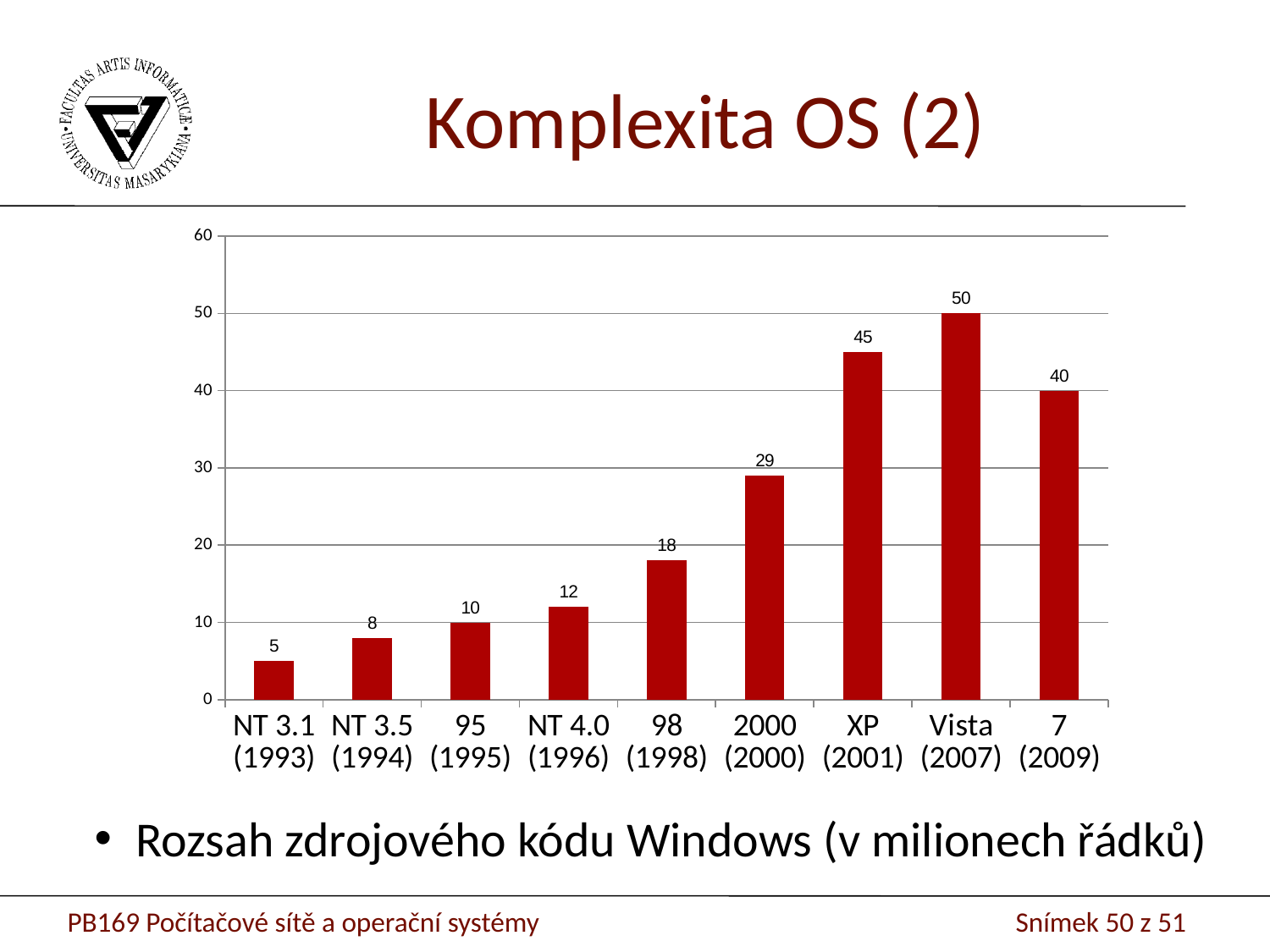
Which category has the lowest value? NT 3.1 (1993) What is the difference between the values for XP (2001) and 98 (1998)? 27 Which is larger, the value for NT 4.0 (1996) or the value for 95 (1995)? NT 4.0 (1996) What kind of chart is shown on the slide? bar chart Do the values rise or fall from NT 3.1 (1993) to Vista (2007)? rise Which category has the highest value? Vista (2007) How many categories are shown on the x axis? 9 What is the difference between the values for Vista (2007) and 7 (2009)? 10 What is the value for NT 3.1 (1993)? 5 Is the value for XP (2001) greater or less than 40? greater What is the value for 2000 (2000)? 29 What is the value for Vista (2007)? 50